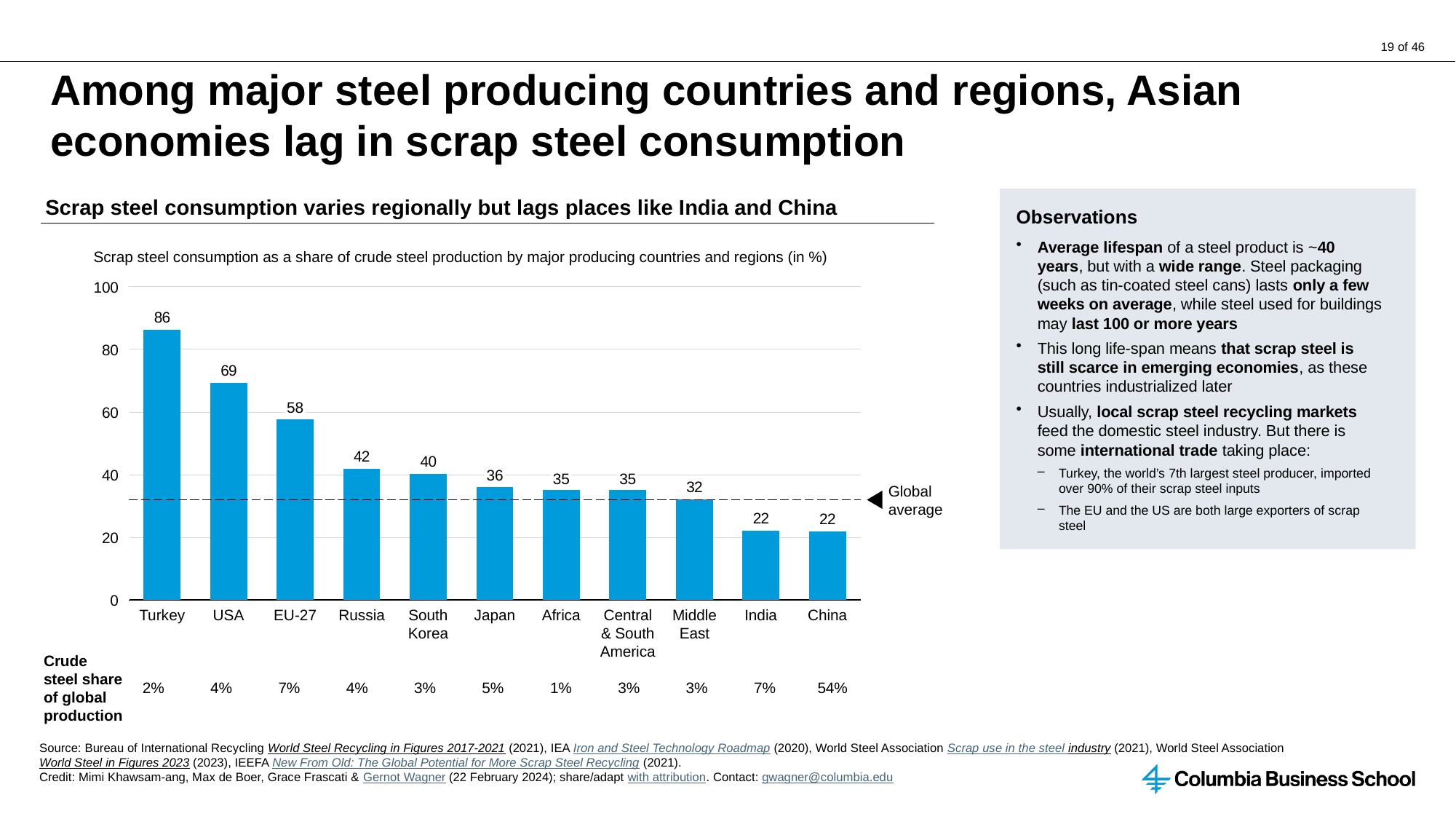
What is the difference between the scrap steel consumption shares of Turkey and China? 64 What is the scrap steel consumption share for Turkey? 86 What is the crude steel share of global production shown for China below the chart? 54% Do the bar values rise or fall from left to right along the x axis? Fall What kind of chart is shown on the slide? Bar chart Is the value for the Middle East greater or less than 40? less Which has a larger scrap steel consumption share, Russia or South Korea? Russia Which country or region has the highest scrap steel consumption share? Turkey What is the scrap steel consumption share for Japan? 36 How many countries and regions are shown on the x axis of the chart? 11 What does the dashed horizontal line on the chart represent? Global average What is the difference between the scrap steel consumption shares of the USA and the EU-27? 11